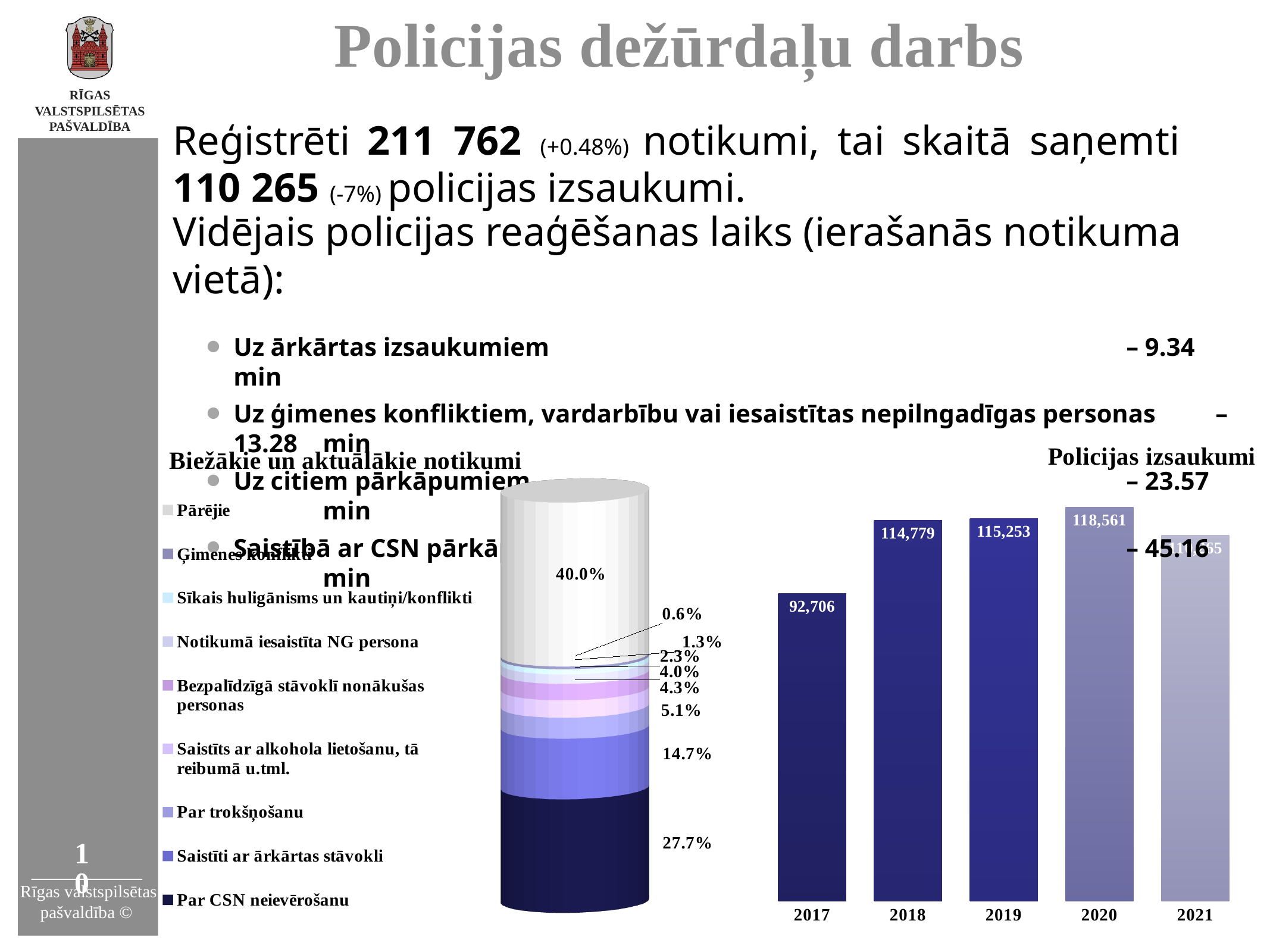
In the 'Policijas izsaukumi' chart, what is the difference between the 2020 and 2017 values? 25,855 In the 'Policijas izsaukumi' chart, which is larger, the value for 2018 or the value for 2019? 2019 What kind of chart is the 'Policijas izsaukumi' chart? bar chart In the 'Policijas izsaukumi' chart, what is the value for 2019? 115,253 In the 'Biežākie un aktuālākie notikumi' chart, what share is labelled for 'Par CSN neievērošanu'? 27.7% In the 'Policijas izsaukumi' chart, what is the value for 2017? 92,706 In the 'Policijas izsaukumi' chart, what is the value for 2020? 118,561 In the 'Biežākie un aktuālākie notikumi' chart, what share is labelled for 'Pārējie'? 40.0% In the 'Policijas izsaukumi' chart, which year has the highest value? 2020 How many categories does the legend of the 'Biežākie un aktuālākie notikumi' chart list? 9 How many years are shown in the 'Policijas izsaukumi' chart? 5 In the 'Policijas izsaukumi' chart, which year has the lowest value? 2017